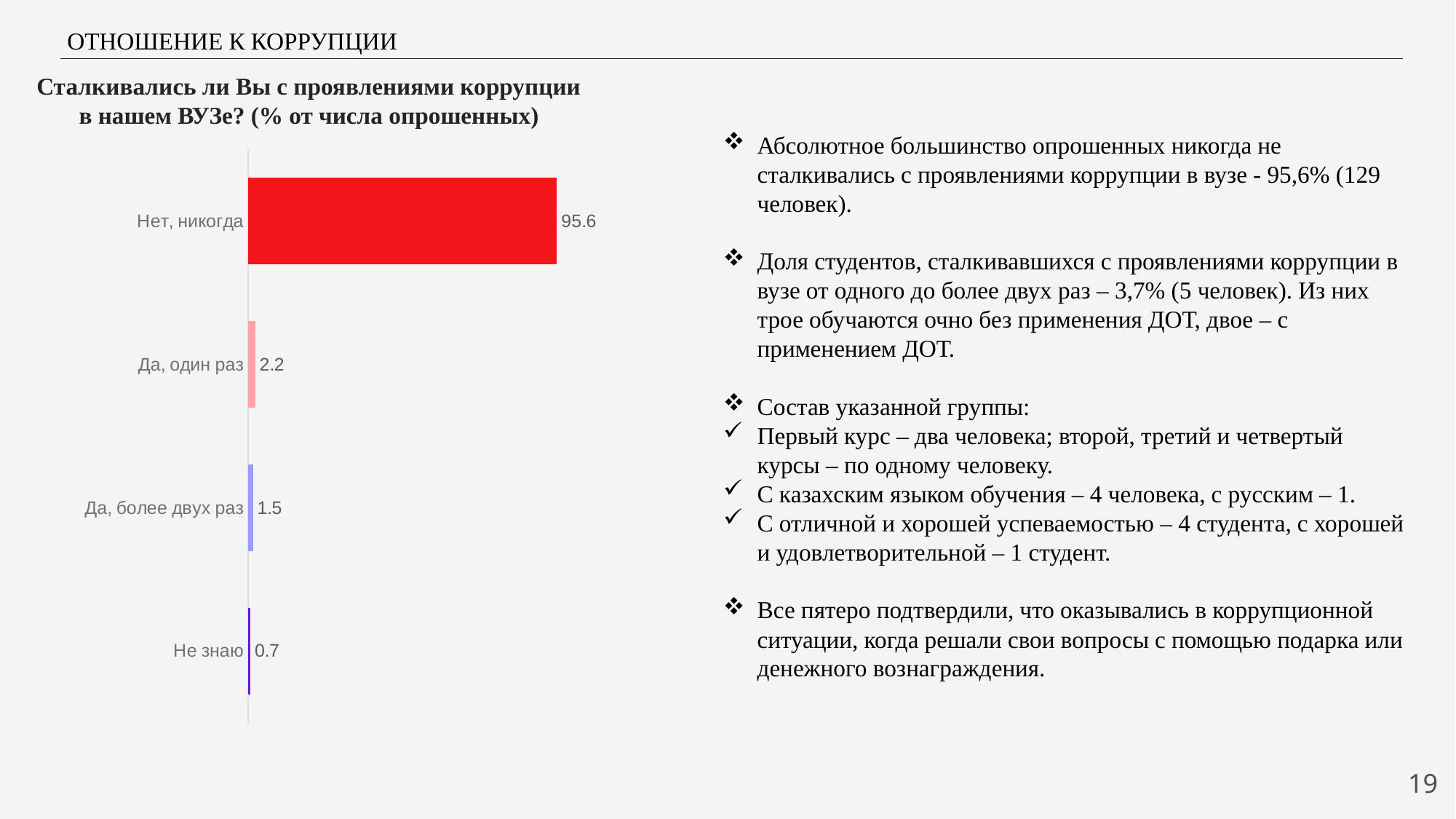
Which category has the highest value? Нет, никогда How many categories are shown in the chart? 4 What colour is the bar for "Нет, никогда"? Red What is the value for "Нет, никогда"? 95.6 What is the difference between the values for "Нет, никогда" and "Да, один раз"? 93.4 What is the value for "Да, более двух раз"? 1.5 What is the value for "Не знаю"? 0.7 What kind of chart is shown on the slide? Bar chart Which is larger, the value for "Да, один раз" or the value for "Не знаю"? Да, один раз What is the value for "Да, один раз"? 2.2 What is the difference between the values for "Да, один раз" and "Да, более двух раз"? 0.7 Which category has the lowest value? Не знаю